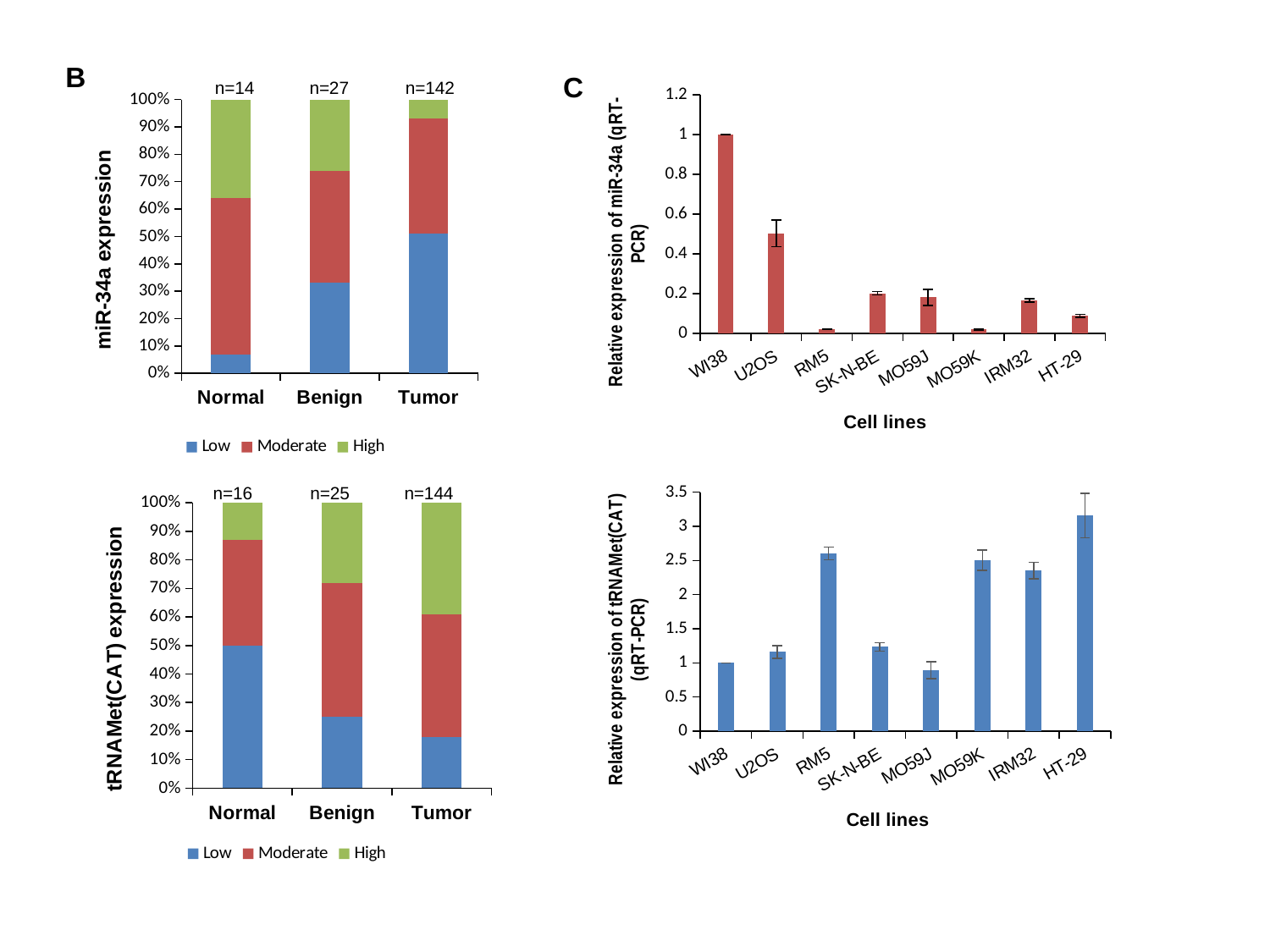
In the bottom-right chart (Relative expression of tRNAMet(CAT)), which is larger, RM5 or SK-N-BE? RM5 What is the x-axis title of the top-right chart (Relative expression of miR-34a)? Cell lines In the bottom-left chart (tRNAMet(CAT) expression), what is the n value shown above the Benign bar? n=25 In the top-right chart (Relative expression of miR-34a), is the value for U2OS greater or less than 0.4? greater In the top-left chart (miR-34a expression), what is the n value shown above the Tumor bar? n=142 What kind of chart is the top-left chart titled miR-34a expression? bar chart In the top-right chart (Relative expression of miR-34a), which cell line has the highest value? WI38 How many series does the legend of the bottom-left chart (tRNAMet(CAT) expression) list? 3 In the bottom-right chart (Relative expression of tRNAMet(CAT)), which cell line has the highest value? HT-29 In the top-right chart (Relative expression of miR-34a), how many cell lines are shown on the x axis? 8 In the top-left chart (miR-34a expression), is the Low share for Normal greater or less than 10%? less In the bottom-right chart (Relative expression of tRNAMet(CAT)), is the value for RM5 greater or less than 2? greater